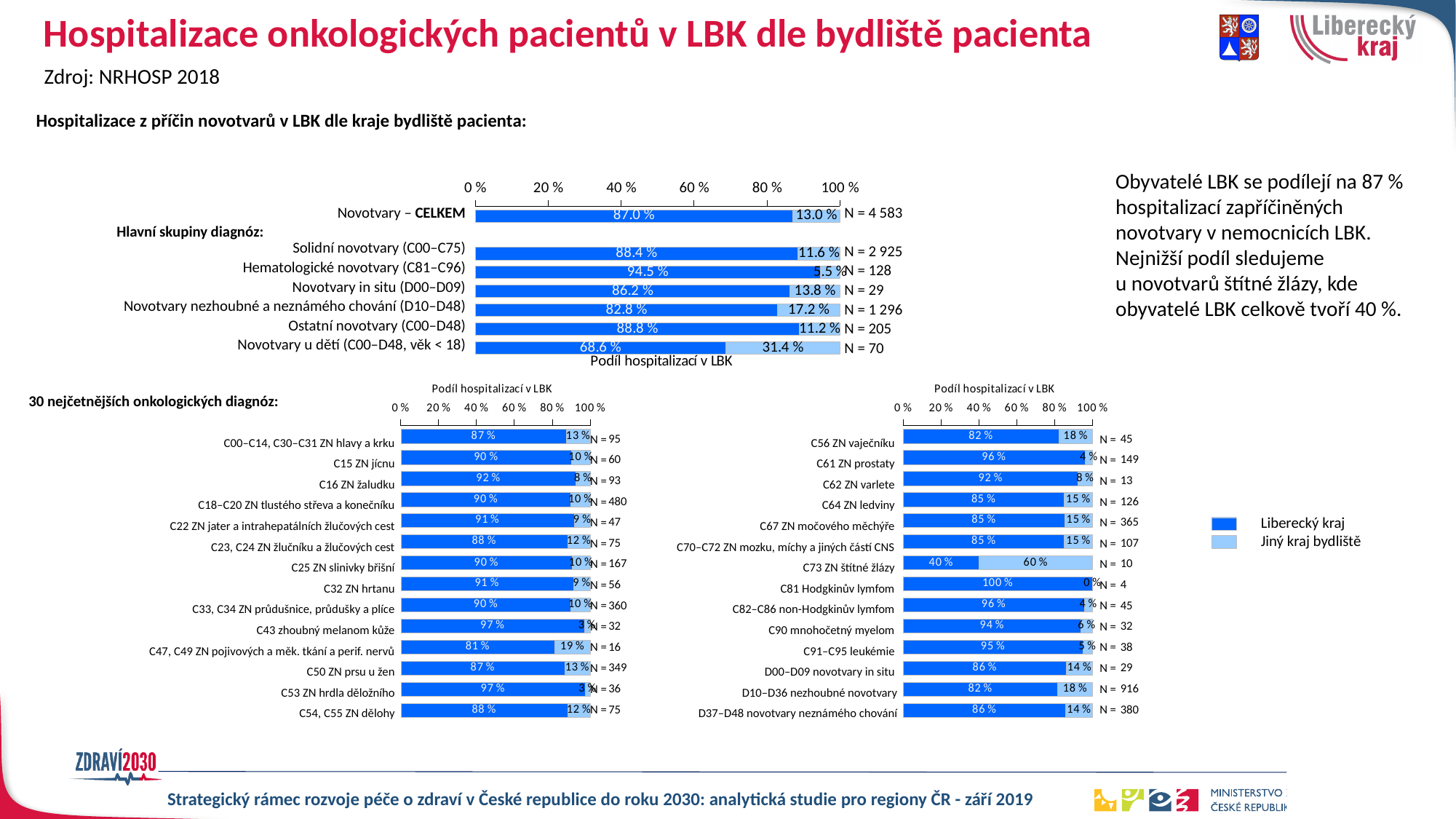
In the top chart (Hlavní skupiny diagnóz), what is the difference in Liberecký kraj share between Hematologické novotvary (C81–C96) and Solidní novotvary (C00–C75)? 6.1 percentage points In the bottom-left chart, which diagnosis has the lowest Liberecký kraj share? C47, C49 ZN pojivových a měk. tkání a perif. nervů In the top chart (Hlavní skupiny diagnóz), which category has the lowest Liberecký kraj share? Novotvary u dětí (C00–D48, věk < 18) In the bottom-right chart, which has the larger Liberecký kraj share: C61 ZN prostaty or C56 ZN vaječníku? C61 ZN prostaty In the top chart (Hlavní skupiny diagnóz), which category has the highest Liberecký kraj share? Hematologické novotvary (C81–C96) In the top chart (Hlavní skupiny diagnóz), what share of hospitalizations for Novotvary u dětí (C00–D48, věk < 18) is for Jiný kraj bydliště? 31.4 % In the top chart (Hlavní skupiny diagnóz), what share of hospitalizations for Hematologické novotvary (C81–C96) is for Liberecký kraj residents? 94.5 % How many categories are plotted in the top chart (Hlavní skupiny diagnóz)? 7 How many series does the legend list? 2 In the bottom-right chart, which diagnosis has the lowest Liberecký kraj share? C73 ZN štítné žlázy In the bottom-right chart, what is the Liberecký kraj share for C73 ZN štítné žlázy? 40 % What type of chart is used on this slide? Bar chart